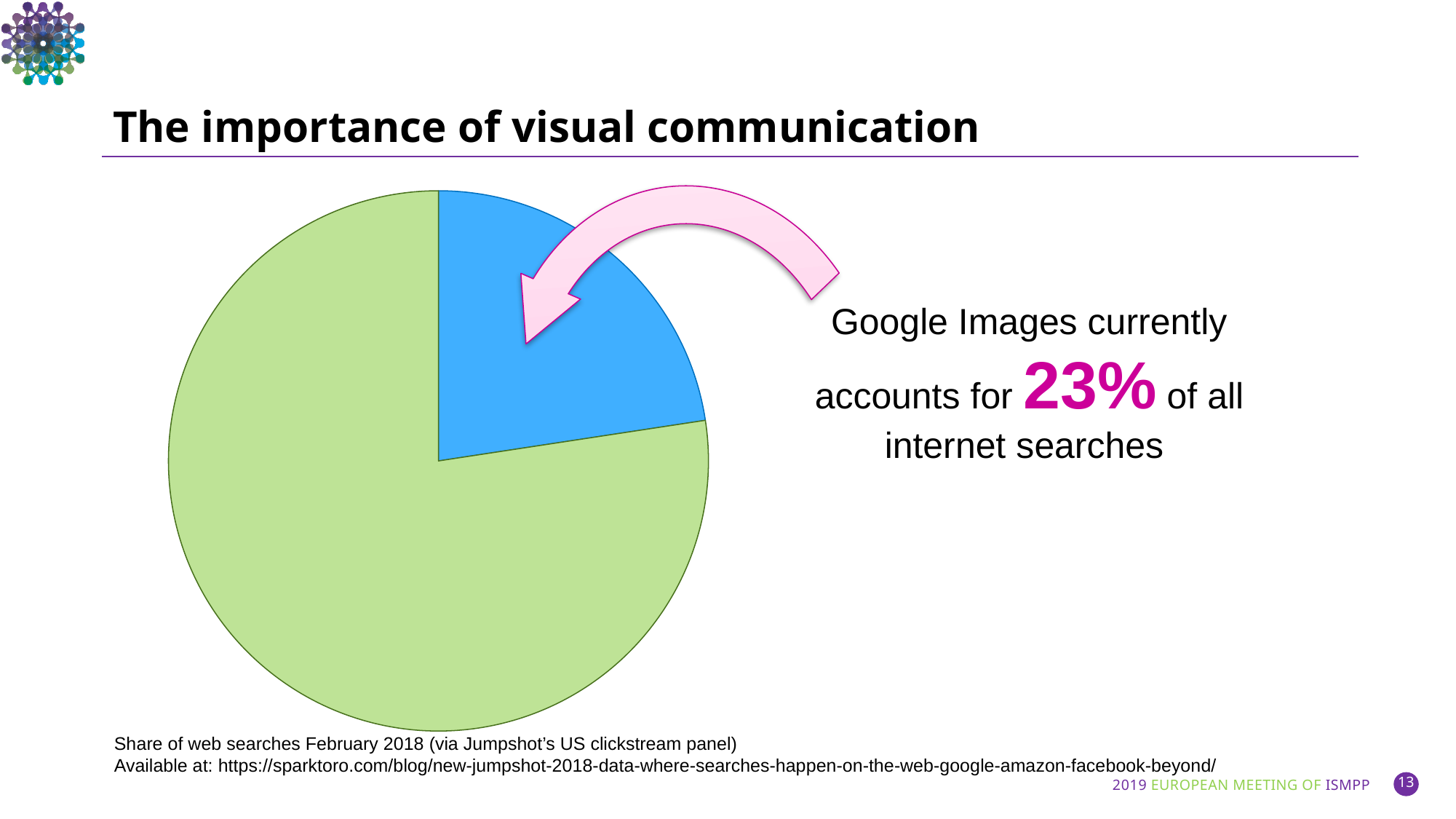
Which slice of the pie chart is larger, the blue slice or the green slice? the green slice Which slice of the pie chart represents Google Images, the blue one or the green one? the blue one What share of all internet searches does Google Images account for, according to the slide? 23% Which slice of the pie chart is the smallest? the blue slice (Google Images) Is the share of the green slice greater or less than 50%? greater Is the share of the blue slice (Google Images) greater or less than 50%? less What time period does the pie chart's data refer to, according to the note below the chart? February 2018 How many slices does the pie chart have? 2 What kind of chart is shown on the slide? pie chart